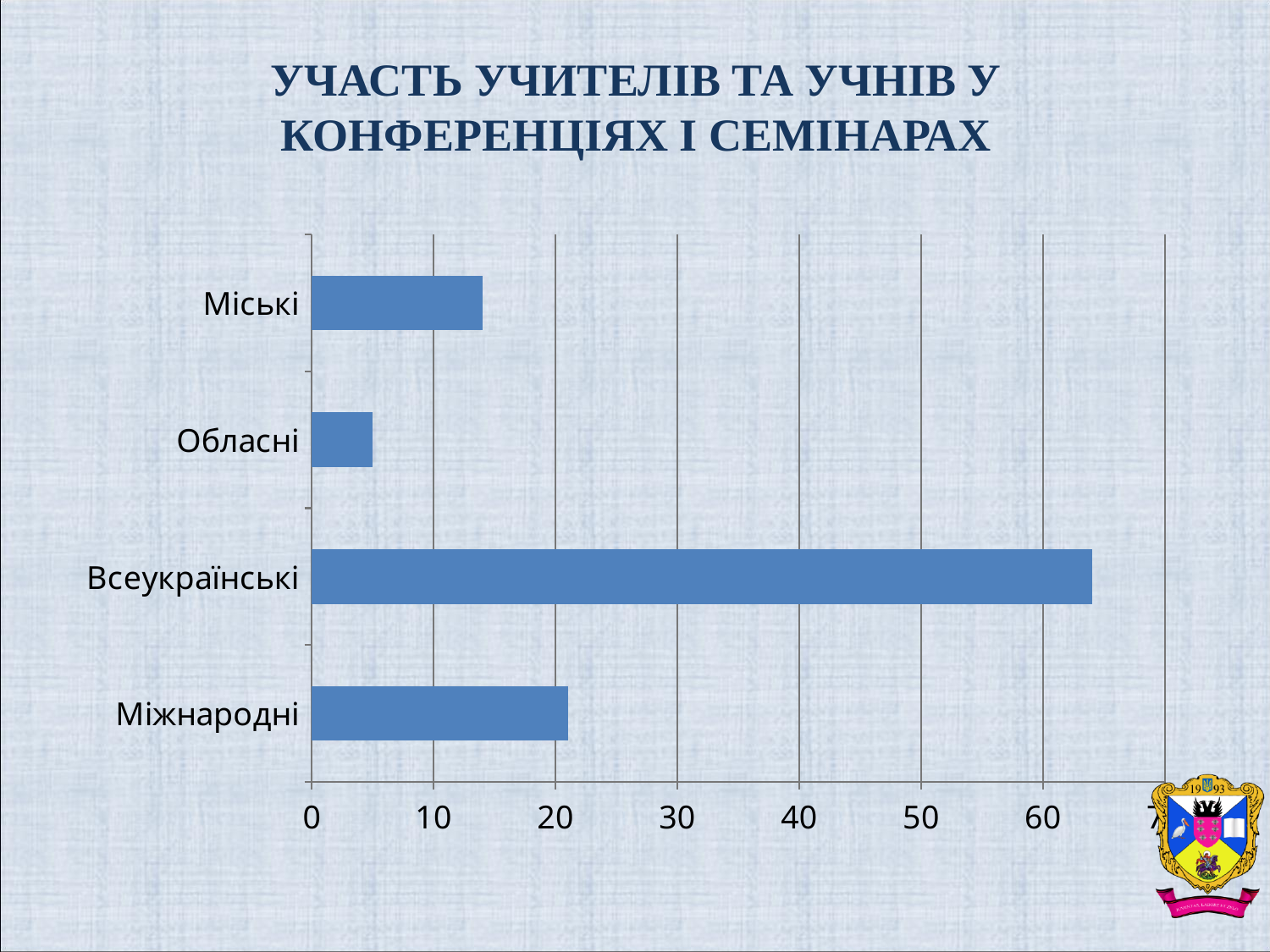
What is the title of the chart on the slide? УЧАСТЬ УЧИТЕЛІВ ТА УЧНІВ У КОНФЕРЕНЦІЯХ І СЕМІНАРАХ How many categories are plotted in the chart? 4 Is the value for Обласні greater or less than 10? less Which category has the lowest value? Обласні Is the value for Всеукраїнські greater or less than 60? greater Which is larger, the value for Міжнародні or the value for Міські? Міжнародні Is the value for Міські greater or less than 20? less Which is larger, the value for Обласні or the value for Всеукраїнські? Всеукраїнські What kind of chart is shown on the slide? bar chart Which category has the highest value? Всеукраїнські